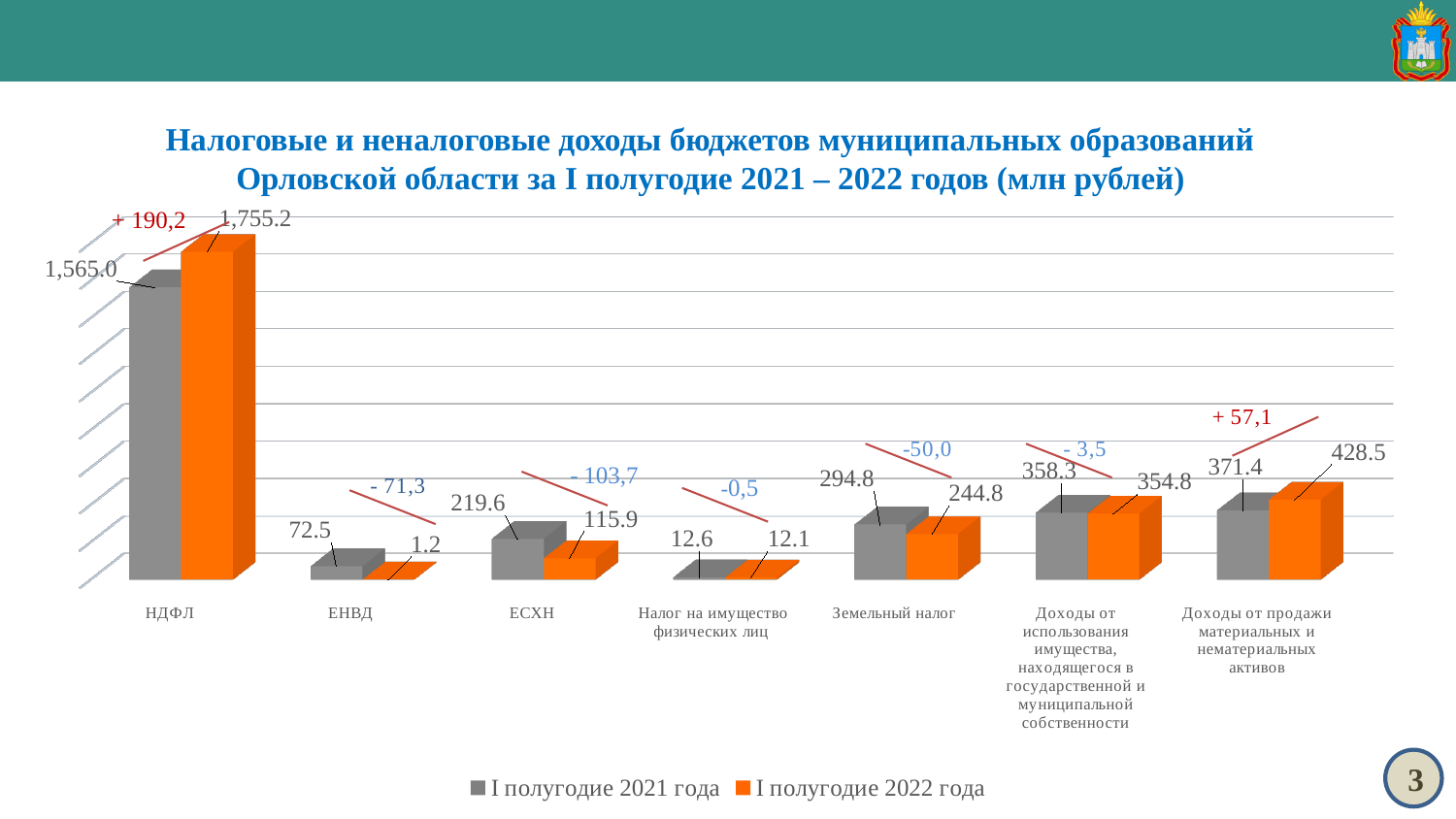
What is the difference between the I полугодие 2022 года and I полугодие 2021 года values for ЕСХН? 103.7 For Земельный налог, which series has the larger value: I полугодие 2021 года or I полугодие 2022 года? I полугодие 2021 года What is the value for НДФЛ in the series I полугодие 2022 года? 1,755.2 Which colour represents the series I полугодие 2022 года in the chart? Orange What is the value for Доходы от продажи материальных и нематериальных активов in the series I полугодие 2021 года? 371.4 Which category has the highest value in the series I полугодие 2021 года? НДФЛ How many series does the legend list? 2 How many categories are shown on the x axis of the chart? 7 What is the value for Земельный налог in the series I полугодие 2022 года? 244.8 What kind of chart is shown on the slide? Bar chart Which category has the lowest value in the series I полугодие 2022 года? ЕНВД What is the value for ЕНВД in the series I полугодие 2021 года? 72.5